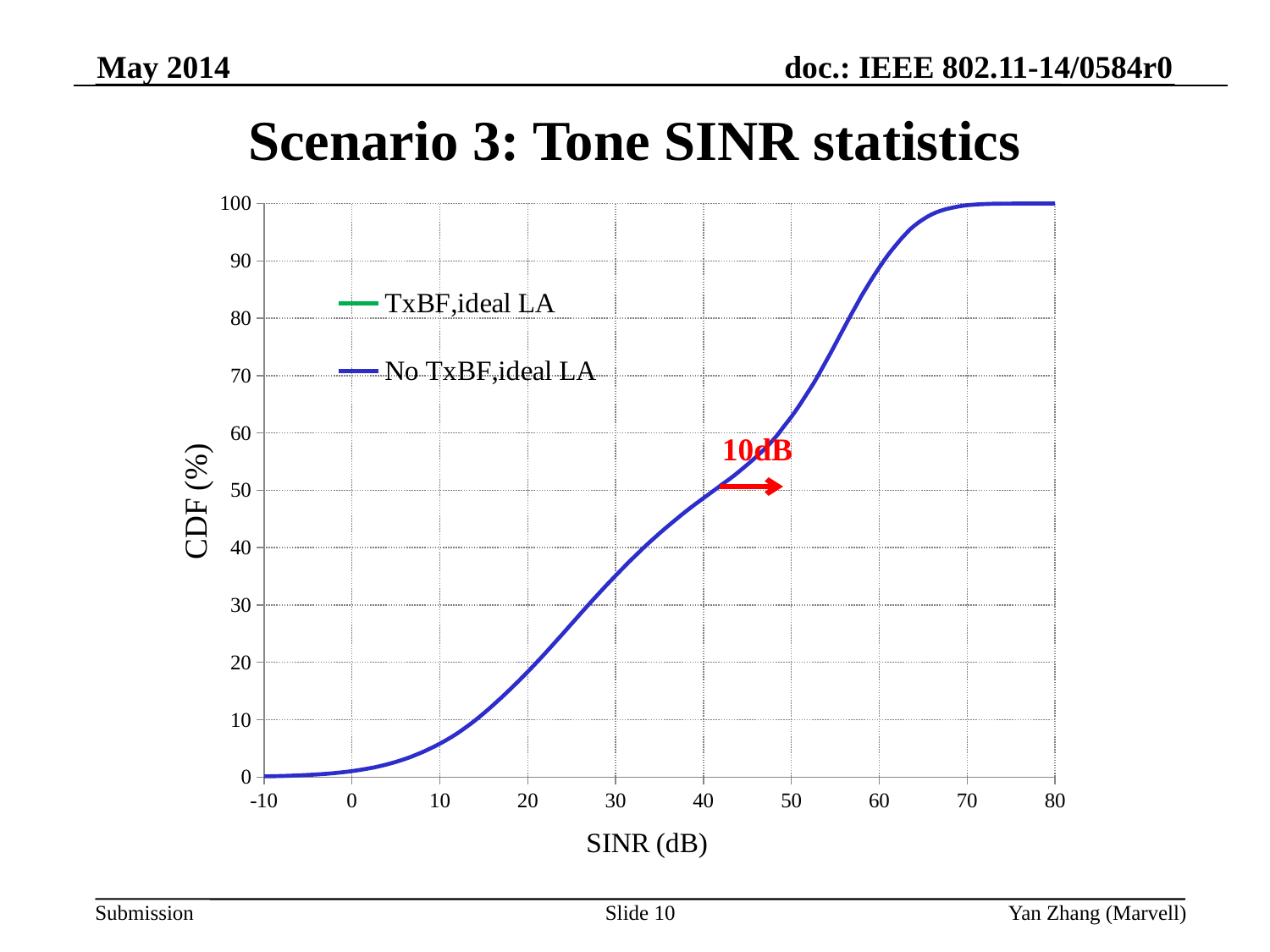
What is the title of the chart? Scenario 3: Tone SINR statistics Is the CDF value of the No TxBF,ideal LA curve at 70 dB SINR greater or less than 90%? greater Is the CDF value of the No TxBF,ideal LA curve at 0 dB SINR greater or less than 10%? less What is the label of the x axis? SINR (dB) Does the No TxBF,ideal LA curve rise or fall as SINR increases? rise What is the maximum SINR value shown on the x axis? 80 What kind of chart is shown on the slide? line chart Is the CDF value of the No TxBF,ideal LA curve at 30 dB SINR greater or less than 30%? greater How many series does the legend list? 2